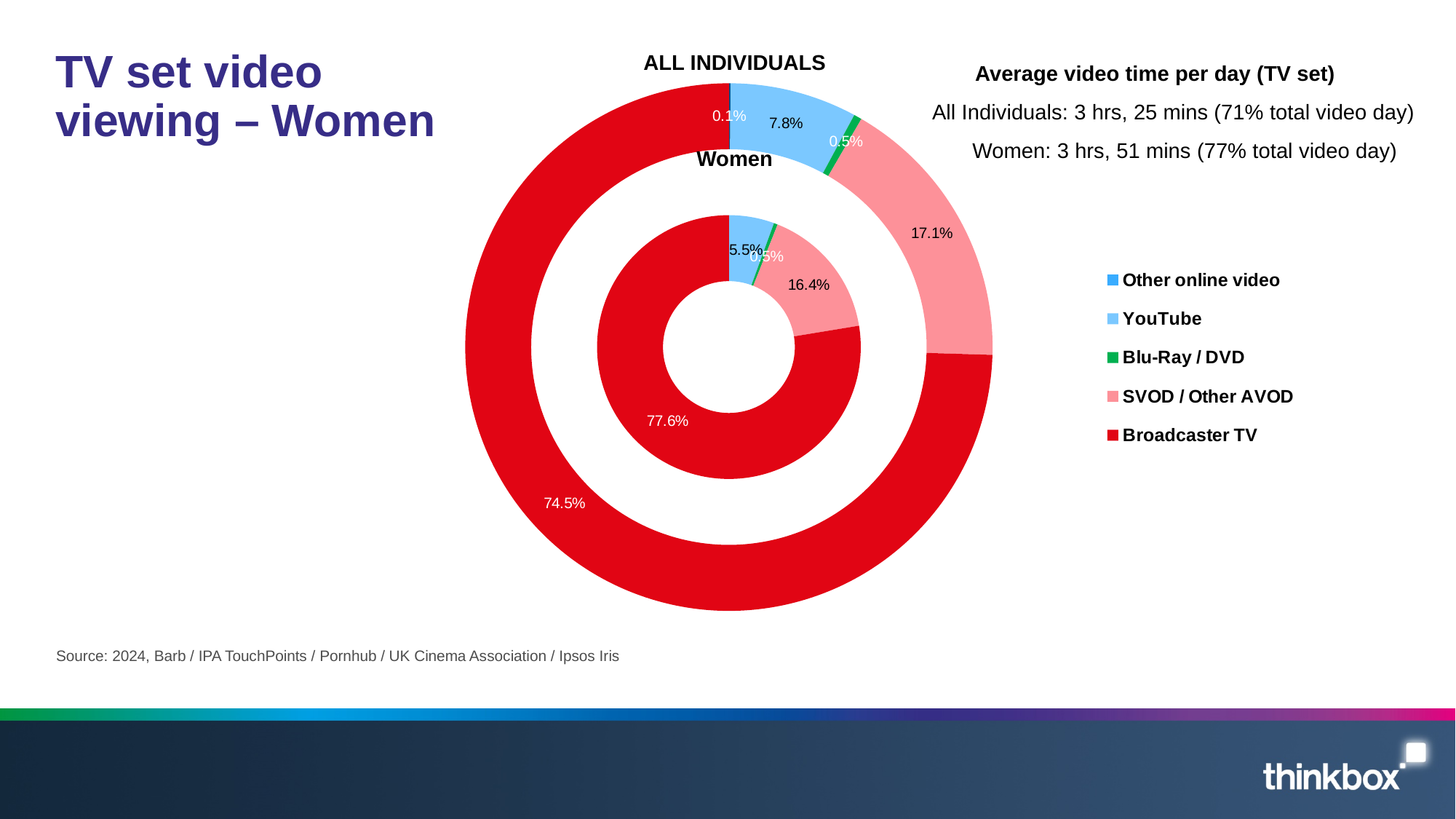
What is the SVOD / Other AVOD share for Women? 16.4% Is the YouTube share larger for All Individuals or for Women? All Individuals What share of TV set video viewing for All Individuals is Broadcaster TV? 74.5% Which category has the smallest labelled share in the All Individuals ring? Other online video How much higher is the Broadcaster TV share for Women than for All Individuals? 3.1 percentage points What is the YouTube share for Women in the inner ring? 5.5% What share of TV set video viewing for Women is Broadcaster TV? 77.6% What is the Blu-Ray / DVD share for All Individuals? 0.5% How many categories does the legend list? 5 What is the YouTube share for All Individuals in the outer ring? 7.8% Which category has the largest share in the Women ring? Broadcaster TV What is the SVOD / Other AVOD share for All Individuals? 17.1%